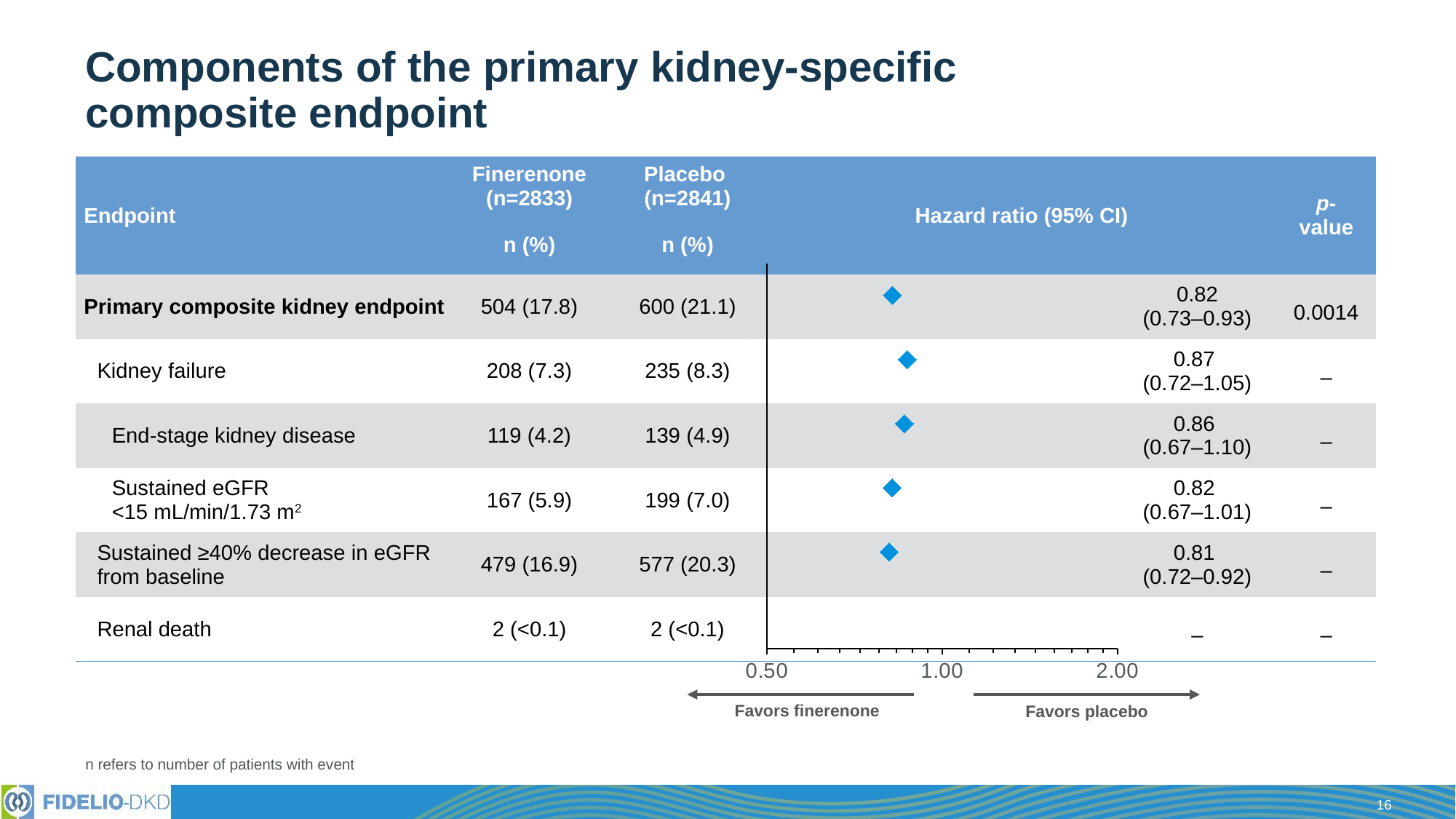
What is the hazard ratio plotted for Kidney failure? 0.87 What does the left side of the hazard ratio axis favor, according to the label below the chart? Favors finerenone Which has the larger hazard ratio, End-stage kidney disease or Sustained eGFR <15 mL/min/1.73 m2? End-stage kidney disease What kind of chart is shown in the Hazard ratio column? Forest plot Which endpoint has the lowest plotted hazard ratio? Sustained ≥40% decrease in eGFR from baseline What is the difference between the hazard ratios for Kidney failure and Sustained ≥40% decrease in eGFR from baseline? 0.06 How many hazard ratio points are plotted on the chart? 5 What is the hazard ratio for the Primary composite kidney endpoint? 0.82 Which endpoint has the highest plotted hazard ratio? Kidney failure What is the hazard ratio plotted for Sustained ≥40% decrease in eGFR from baseline? 0.81 Is the hazard ratio for the Primary composite kidney endpoint greater or less than 1.00? less What is the 95% CI shown for End-stage kidney disease? 0.67–1.10